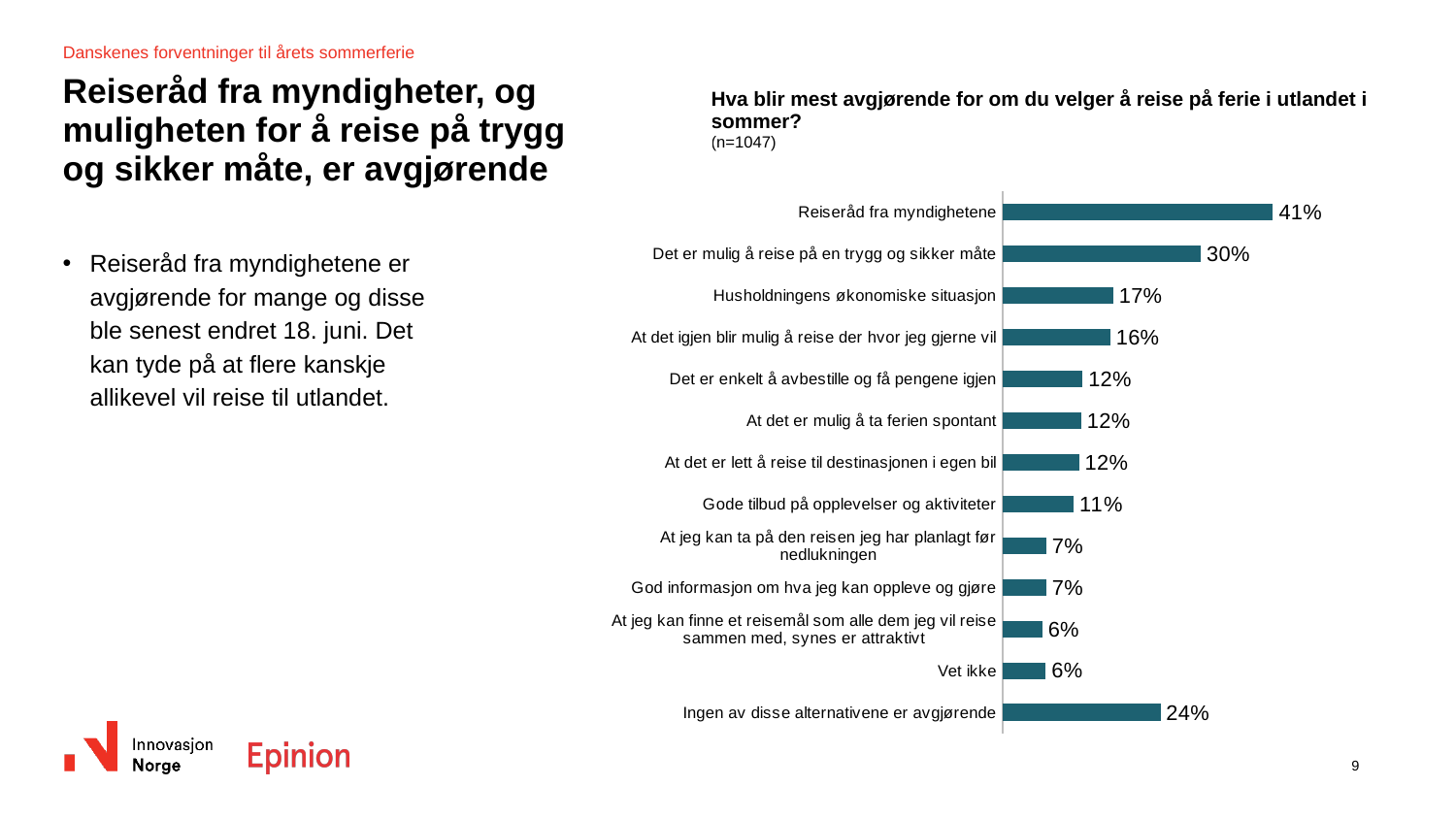
What kind of chart is shown on the slide? Bar chart Which category has the highest value? Reiseråd fra myndighetene What is the value for "Vet ikke"? 6% What is the value for "Husholdningens økonomiske situasjon"? 17% What is the value for "Reiseråd fra myndighetene"? 41% Which is larger: "Husholdningens økonomiske situasjon" or "At det igjen blir mulig å reise der hvor jeg gjerne vil"? Husholdningens økonomiske situasjon What is the value for "Ingen av disse alternativene er avgjørende"? 24% What is the value for "God informasjon om hva jeg kan oppleve og gjøre"? 7% What is the sample size (n) stated under the chart title? 1047 What is the difference between "Reiseråd fra myndighetene" and "Det er mulig å reise på en trygg og sikker måte"? 11 percentage points Which is larger: "Gode tilbud på opplevelser og aktiviteter" or "Ingen av disse alternativene er avgjørende"? Ingen av disse alternativene er avgjørende How many categories are shown in the chart? 13